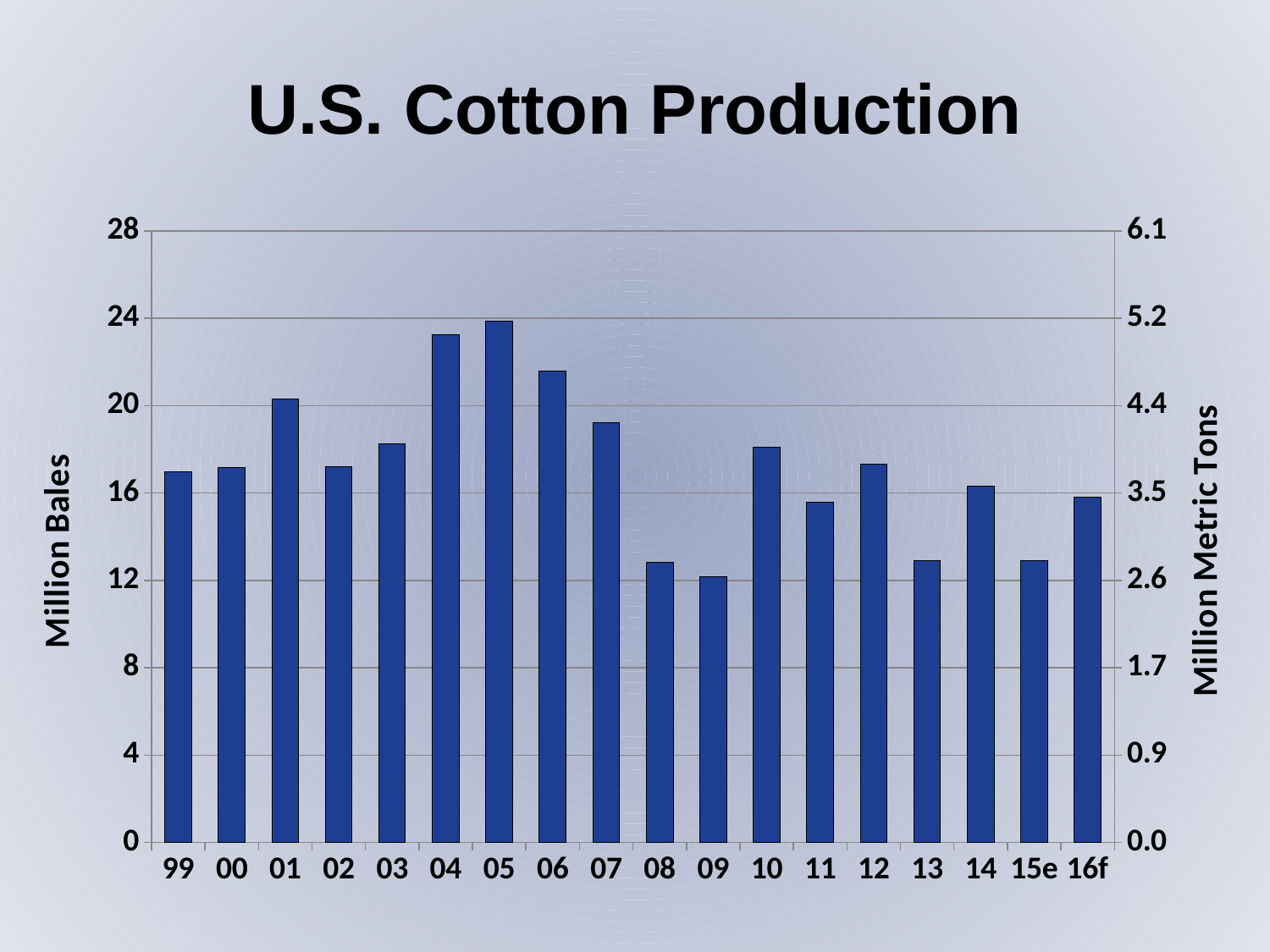
Is the value for 08 greater or less than 16 million bales? less Is the value for 04 greater or less than 20 million bales? greater Which year has the larger value, 10 or 11? 10 What type of chart is shown on the slide? bar chart Is the value for 09 greater or less than 16 million bales? less What is the title of the chart? U.S. Cotton Production Which year has the lowest cotton production? 09 Which year has the highest cotton production? 05 How many years (categories) are shown on the x axis? 18 Which year has the larger value, 04 or 08? 04 Do the values rise or fall from 05 to 09? fall